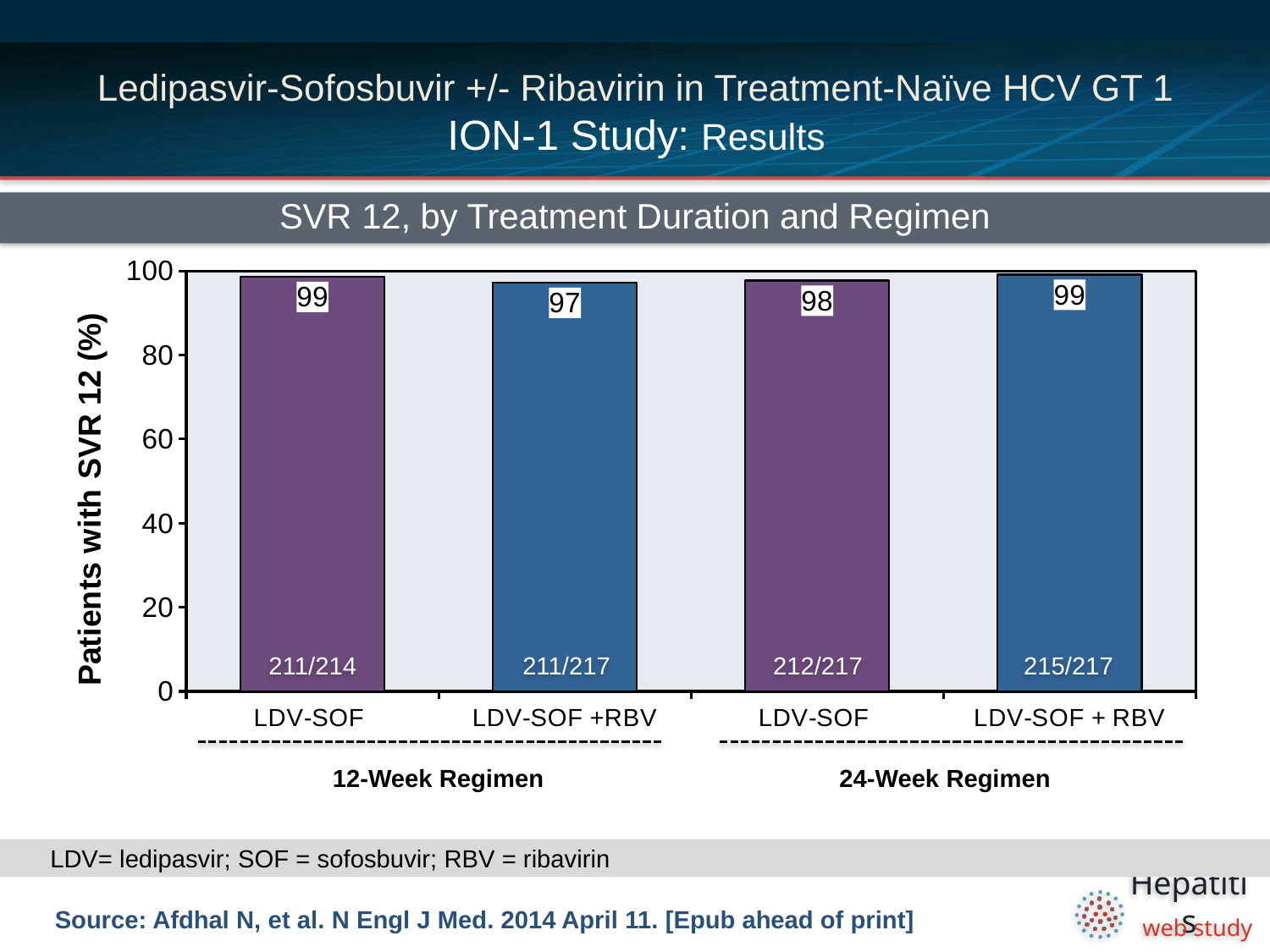
Which bar has the lowest SVR 12 rate? LDV-SOF +RBV, 12-Week Regimen What is the SVR 12 rate for LDV-SOF in the 12-Week Regimen? 99 What is the difference in SVR 12 rate between LDV-SOF and LDV-SOF +RBV in the 12-Week Regimen? 2 What is the SVR 12 rate for LDV-SOF +RBV in the 12-Week Regimen? 97 What is the SVR 12 rate for LDV-SOF in the 24-Week Regimen? 98 What is the title of the chart? SVR 12, by Treatment Duration and Regimen What fraction of patients is shown for LDV-SOF + RBV in the 24-Week Regimen? 215/217 What fraction of patients is shown for LDV-SOF in the 12-Week Regimen? 211/214 Is the SVR 12 rate for LDV-SOF +RBV in the 12-Week Regimen greater or less than 80? greater In the 24-Week Regimen, which has the higher SVR 12 rate: LDV-SOF or LDV-SOF + RBV? LDV-SOF + RBV How many bars are shown in the chart? 4 What type of chart is shown on the slide? Bar chart